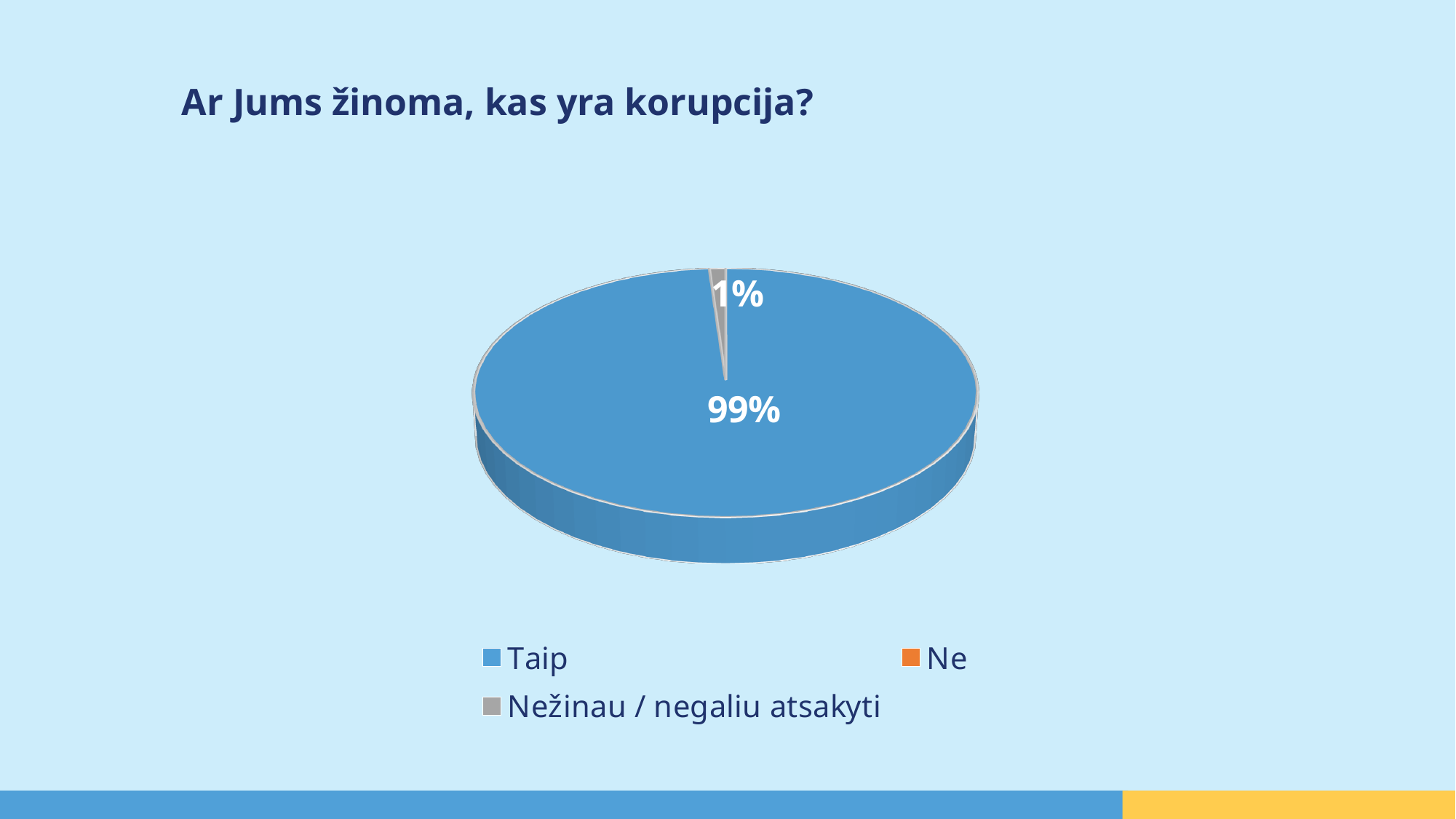
What share of the pie does the "Taip" slice represent? 99% What colour represents the "Taip" category in the legend? Blue What percentage of respondents answered "Taip"? 99% What kind of chart is shown on the slide? Pie chart What is the difference in percentage points between the "Taip" slice and the "Nežinau / negaliu atsakyti" slice? 98% Is the value for "Taip" greater or less than 50%? greater How many categories does the legend list? 3 Which of the two labelled slices is smaller, "Taip" or "Nežinau / negaliu atsakyti"? Nežinau / negaliu atsakyti What is the title of the chart? Ar Jums žinoma, kas yra korupcija? What percentage of respondents answered "Nežinau / negaliu atsakyti"? 1% Which category has the largest slice of the pie? Taip